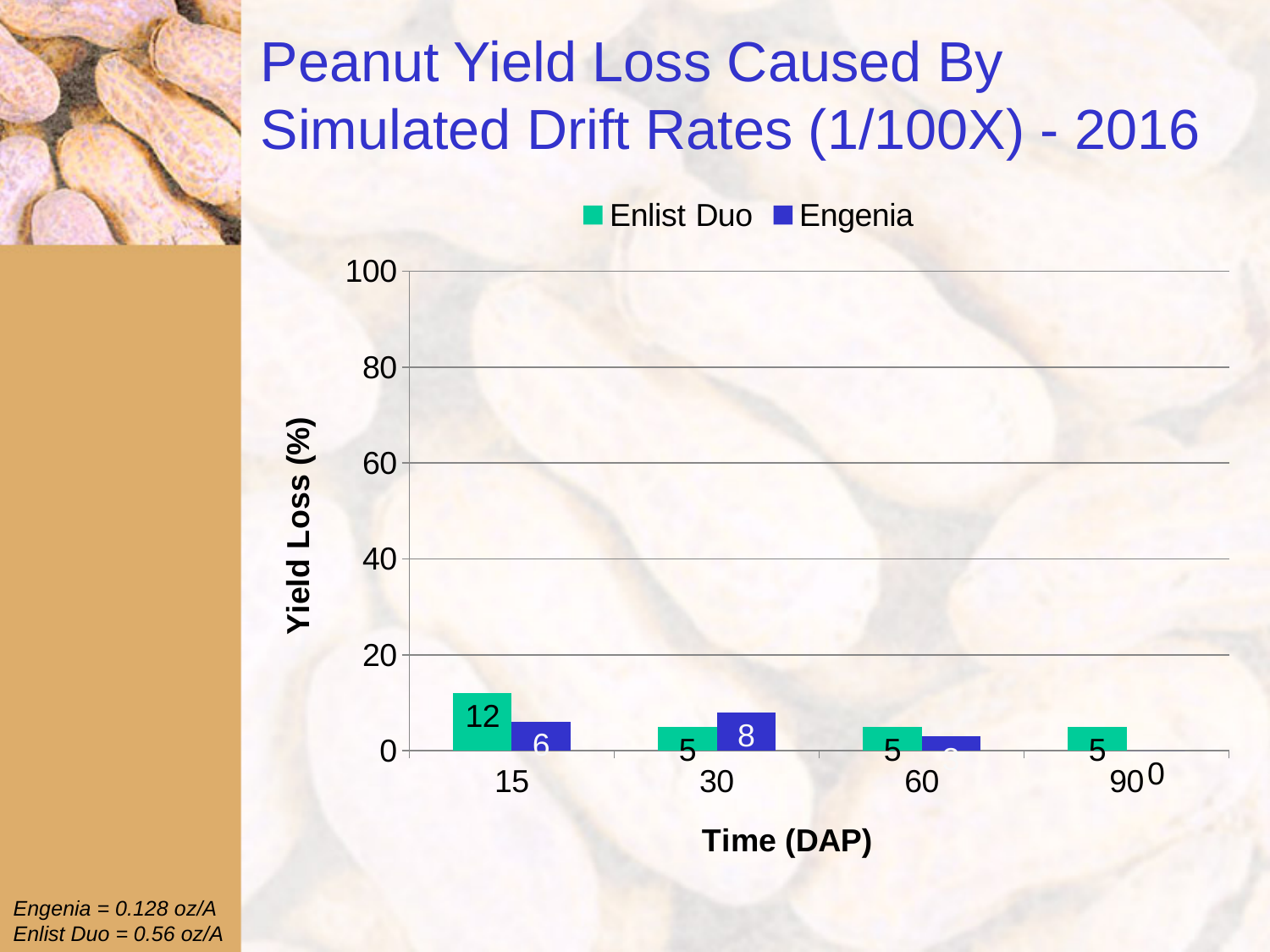
At which time (DAP) is the Engenia yield loss highest? 30 What is the yield loss for Engenia at 30 DAP? 8 What is the yield loss for Engenia at 15 DAP? 6 Is the Enlist Duo yield loss at 15 DAP greater or less than 20? less At which time (DAP) is the Enlist Duo yield loss highest? 15 What is the yield loss for Engenia at 90 DAP? 0 What is the yield loss for Enlist Duo at 30 DAP? 5 How many time points (DAP) are shown on the x axis? 4 What is the yield loss for Enlist Duo at 15 DAP? 12 What is the difference between the Enlist Duo and Engenia yield loss at 15 DAP? 6 How many series does the legend list? 2 At 30 DAP, which has the larger yield loss, Enlist Duo or Engenia? Engenia